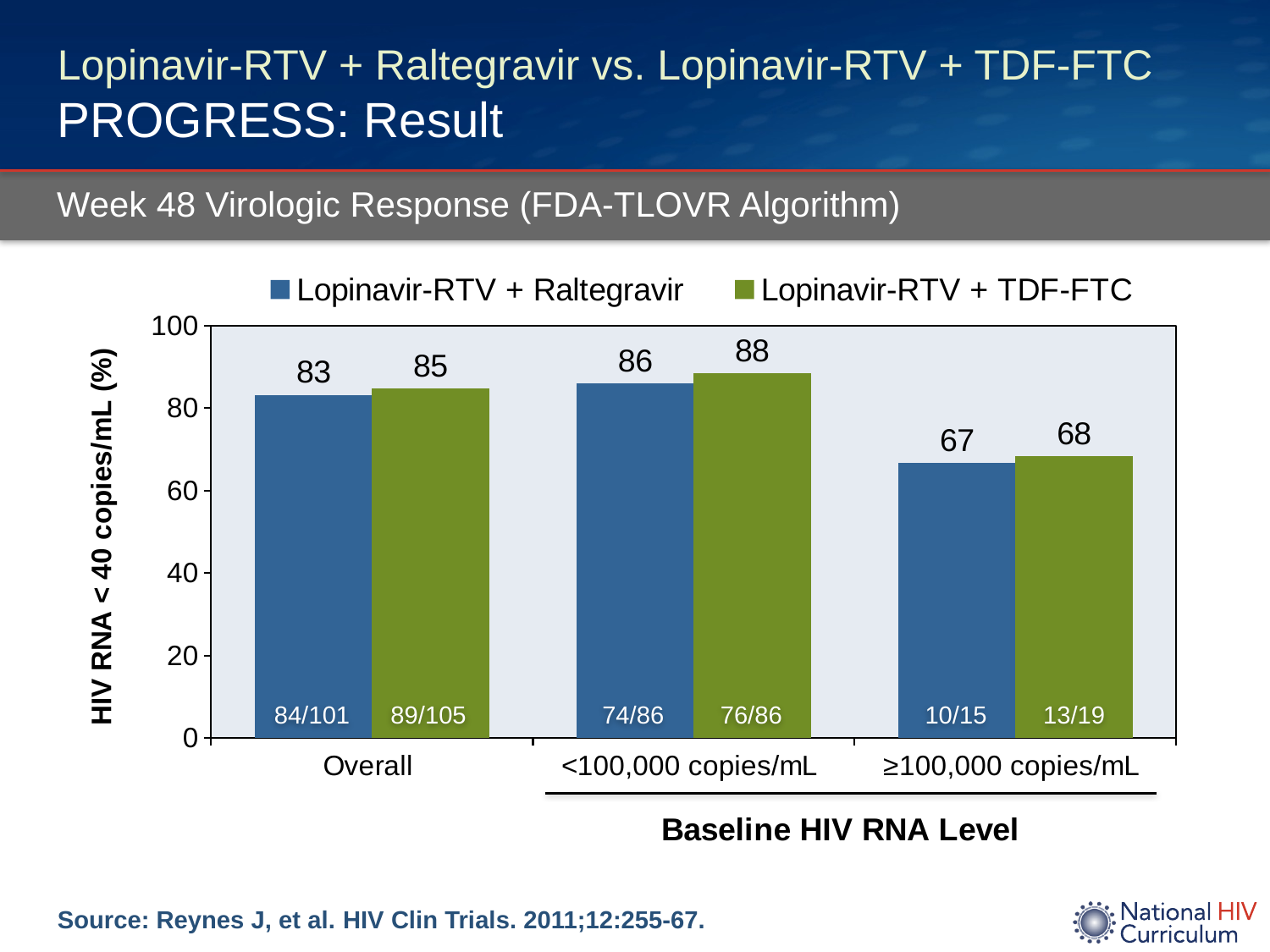
Is the value for Lopinavir-RTV + Raltegravir in the ≥100,000 copies/mL category greater or less than 80? less Which category has the highest value for Lopinavir-RTV + Raltegravir? <100,000 copies/mL How many series does the legend list? 2 What kind of chart is shown on the slide? bar chart What is the value for Lopinavir-RTV + Raltegravir in the ≥100,000 copies/mL category? 67 Which category has the lowest value for Lopinavir-RTV + TDF-FTC? ≥100,000 copies/mL How many categories are shown on the x axis? 3 What is the value for Lopinavir-RTV + TDF-FTC in the <100,000 copies/mL category? 88 What fraction is printed inside the Lopinavir-RTV + TDF-FTC bar in the Overall category? 89/105 What is the difference between the Lopinavir-RTV + TDF-FTC and Lopinavir-RTV + Raltegravir values in the Overall category? 2 What is the value for Lopinavir-RTV + Raltegravir in the Overall category? 83 What is the difference between the <100,000 copies/mL and ≥100,000 copies/mL values for Lopinavir-RTV + TDF-FTC? 20